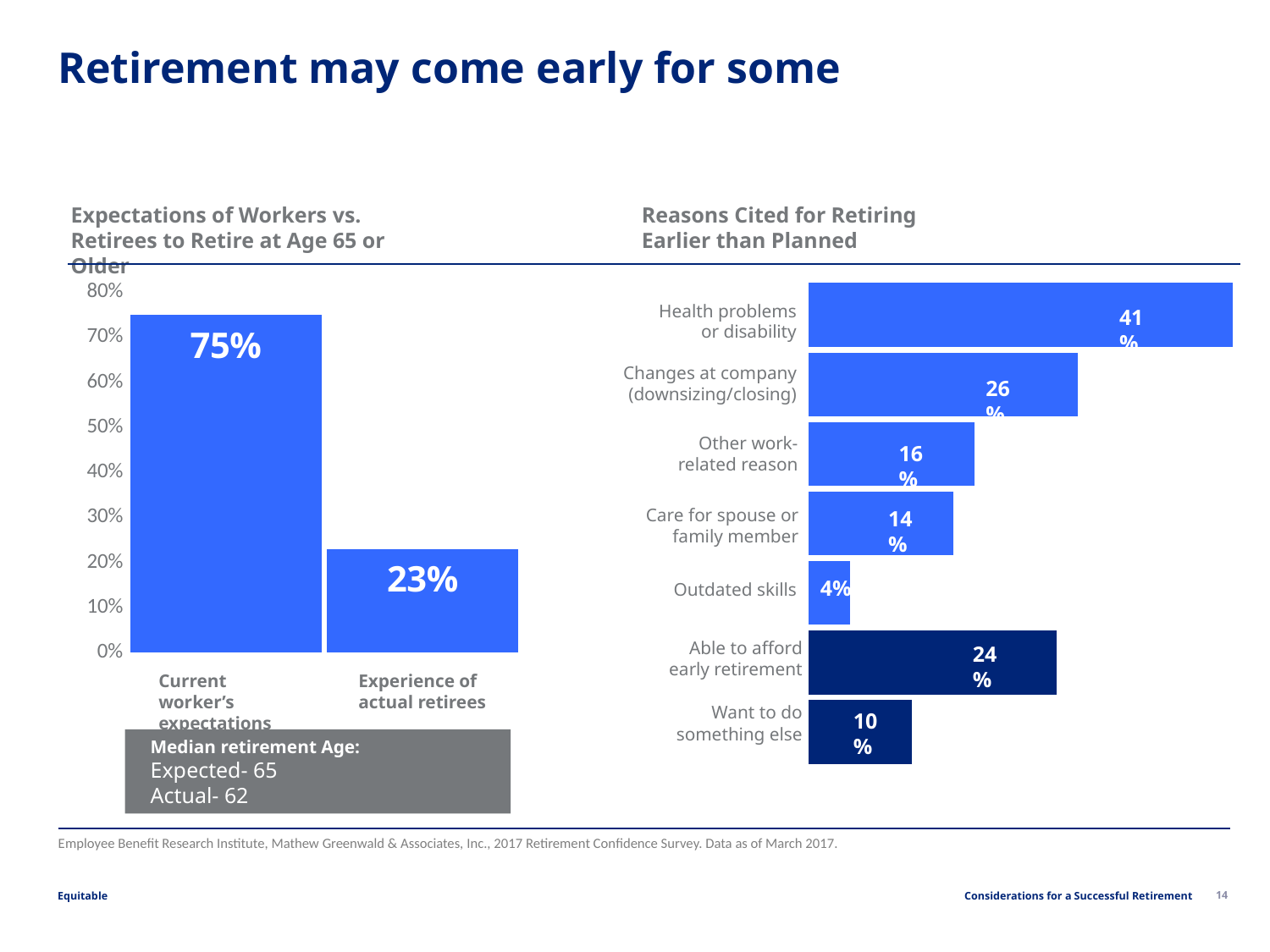
In the left chart, what is the difference between Current worker's expectations and Experience of actual retirees? 52% In the 'Reasons Cited for Retiring Earlier than Planned' chart, what is the difference between Other work-related reason and Care for spouse or family member? 2% In the 'Reasons Cited for Retiring Earlier than Planned' chart, what is the value for Changes at company (downsizing/closing)? 26% In the 'Reasons Cited for Retiring Earlier than Planned' chart, which is larger: Able to afford early retirement or Want to do something else? Able to afford early retirement In the 'Reasons Cited for Retiring Earlier than Planned' chart, which reason has the lowest value? Outdated skills How many reasons are listed in the 'Reasons Cited for Retiring Earlier than Planned' chart? 7 In the left chart, how many bars are plotted? 2 In the left chart, what is the value for Experience of actual retirees? 23% What type of chart is the 'Reasons Cited for Retiring Earlier than Planned' chart? Bar chart In the 'Reasons Cited for Retiring Earlier than Planned' chart, which reason has the highest value? Health problems or disability In the 'Reasons Cited for Retiring Earlier than Planned' chart, what is the value for Health problems or disability? 41% In the left chart, what is the value for Current worker's expectations? 75%